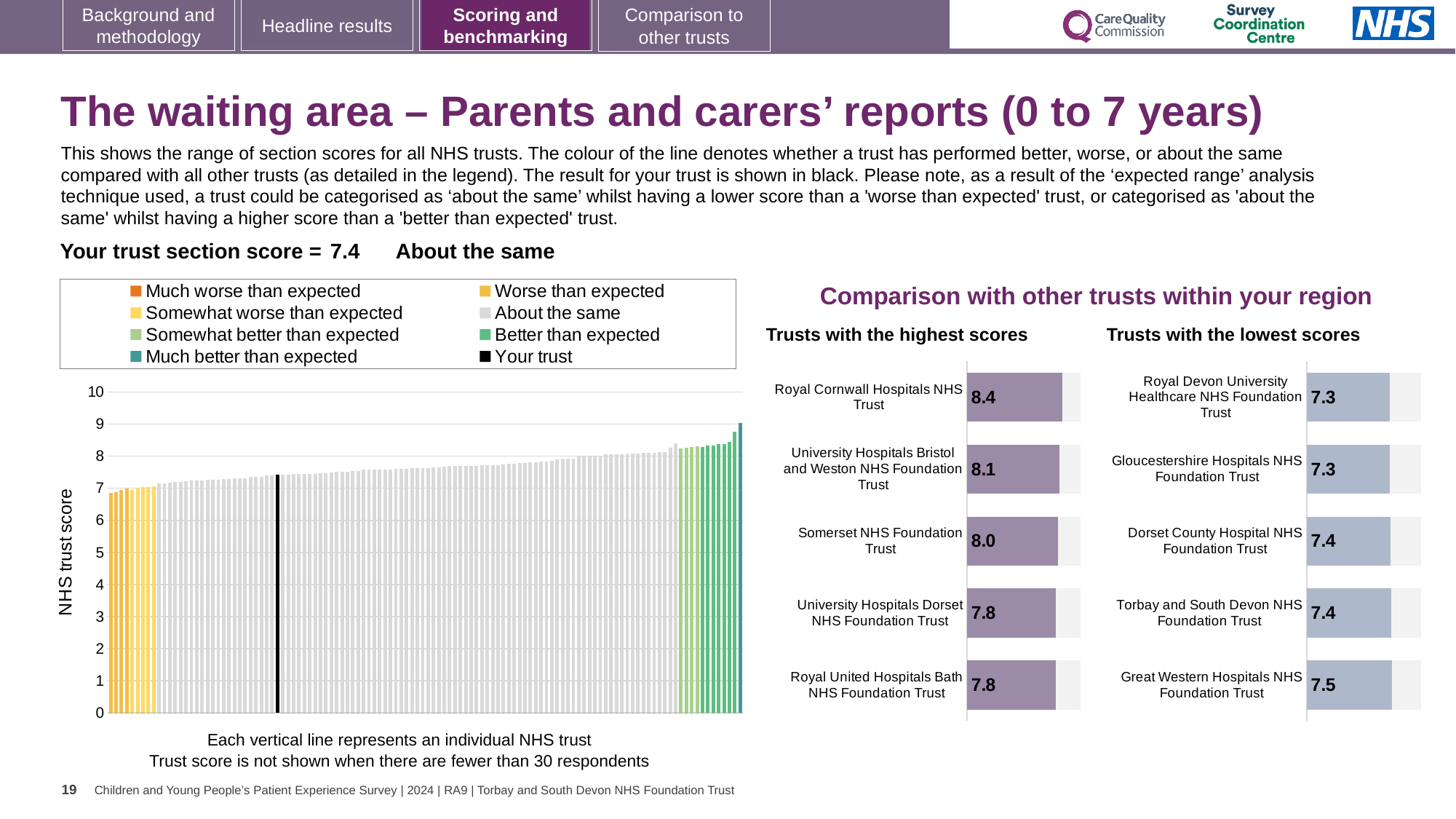
In the 'Trusts with the lowest scores' chart, what is the score for Great Western Hospitals NHS Foundation Trust? 7.5 In the 'Trusts with the highest scores' chart, which trust has the highest score? Royal Cornwall Hospitals NHS Trust In the 'Trusts with the highest scores' chart, what is the score for Somerset NHS Foundation Trust? 8.0 In the 'Trusts with the lowest scores' chart, what is the score for Dorset County Hospital NHS Foundation Trust? 7.4 In the 'Trusts with the highest scores' chart, how many trusts are shown? 5 In the large chart on the left showing all NHS trusts, what kind of chart is it? Bar chart In the large chart on the left showing all NHS trusts, how many entries does the legend list? 8 In the 'Trusts with the lowest scores' chart, what is the difference between the scores of Great Western Hospitals NHS Foundation Trust and Gloucestershire Hospitals NHS Foundation Trust? 0.2 In the 'Trusts with the highest scores' chart, what is the difference between the scores of Royal Cornwall Hospitals NHS Trust and Royal United Hospitals Bath NHS Foundation Trust? 0.6 In the 'Trusts with the highest scores' chart, what is the score for Royal Cornwall Hospitals NHS Trust? 8.4 In the 'Trusts with the highest scores' chart, which has a higher score: University Hospitals Bristol and Weston NHS Foundation Trust or University Hospitals Dorset NHS Foundation Trust? University Hospitals Bristol and Weston NHS Foundation Trust In the 'Trusts with the lowest scores' chart, which trust has the highest score? Great Western Hospitals NHS Foundation Trust